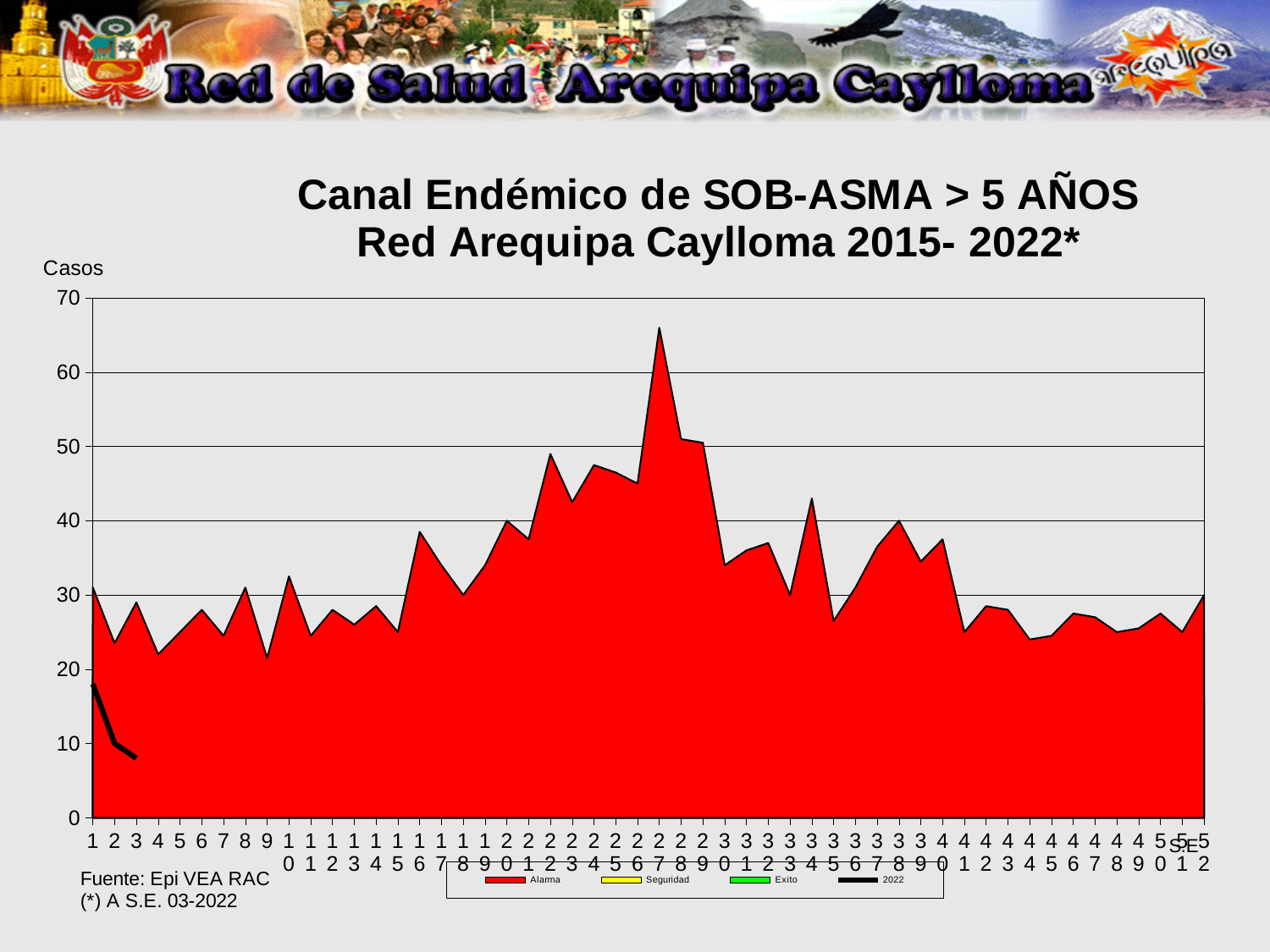
What are the entries listed in the chart legend? Alarma, Seguridad, Exito, 2022 In which epidemiological week does the Alarma area reach its highest value? 27 Is the 2022 value at week 3 greater or less than 10? less Is the 2022 value at week 1 greater or less than 10? greater What is the label on the vertical axis of the chart? Casos At week 1, which is larger: the Alarma value or the 2022 value? Alarma Is the Alarma value at week 1 greater or less than 20? greater Does the 2022 line rise or fall from week 1 to week 3? fall What kind of chart is shown on the slide? combination area and line chart How many series does the legend list? 4 How many epidemiological weeks are shown along the x axis? 52